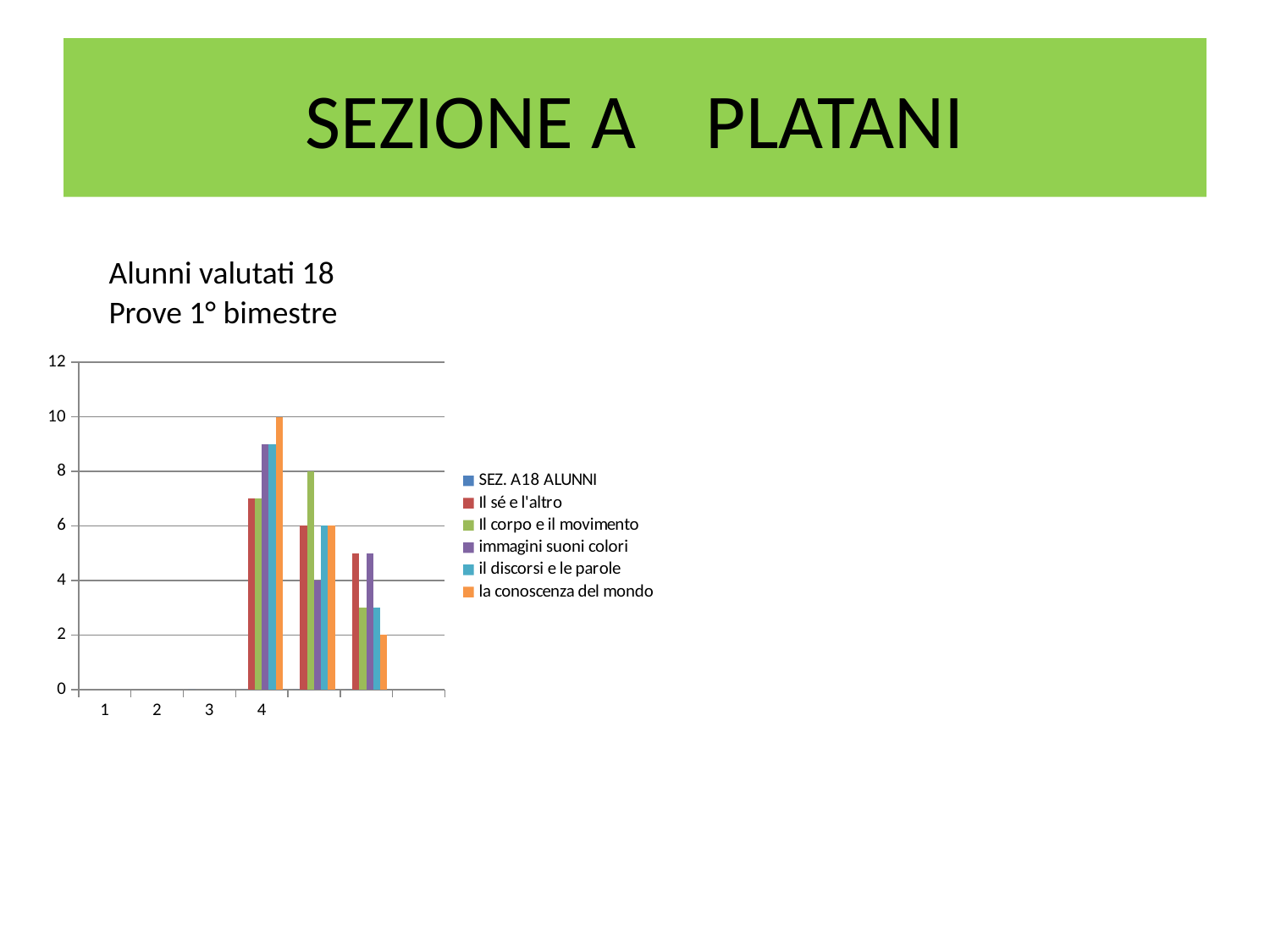
Is the value for 'Il sé e l'altro' at category 4 greater or less than 8? less What kind of chart is shown on the slide? bar chart How many series does the legend list? 6 Which series has the highest value at category 4? la conoscenza del mondo What is the highest value shown on the vertical axis? 12 At category 4, which is larger: 'Il sé e l'altro' or 'la conoscenza del mondo'? la conoscenza del mondo What is the first entry listed in the legend? SEZ. A18 ALUNNI What is the value of 'la conoscenza del mondo' at category 4? 10